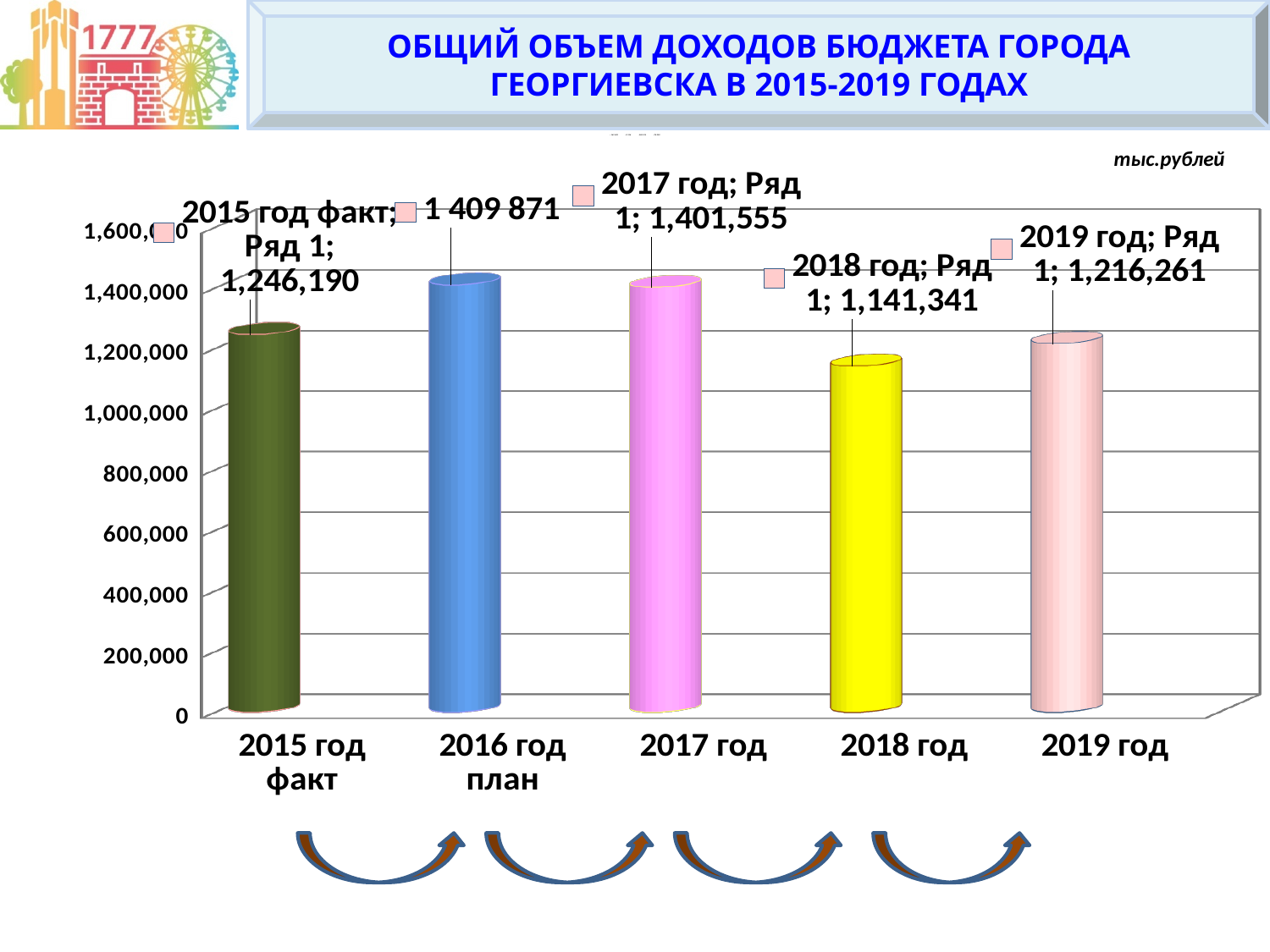
What is the value for 2016 год план? 1 409 871 What kind of chart is shown on the slide? Bar chart What is the value for 2017 год? 1,401,555 Which category has the lowest value? 2018 год Which category has the highest value? 2016 год план What is the value for 2015 год факт? 1,246,190 What is the value for 2018 год? 1,141,341 What is the difference between the values for 2019 год and 2018 год? 74,920 Which is larger, the value for 2015 год факт or the value for 2019 год? 2015 год факт What is the difference between the values for 2015 год факт and 2018 год? 104,849 How many categories are shown on the x axis? 5 What is the value for 2019 год? 1,216,261